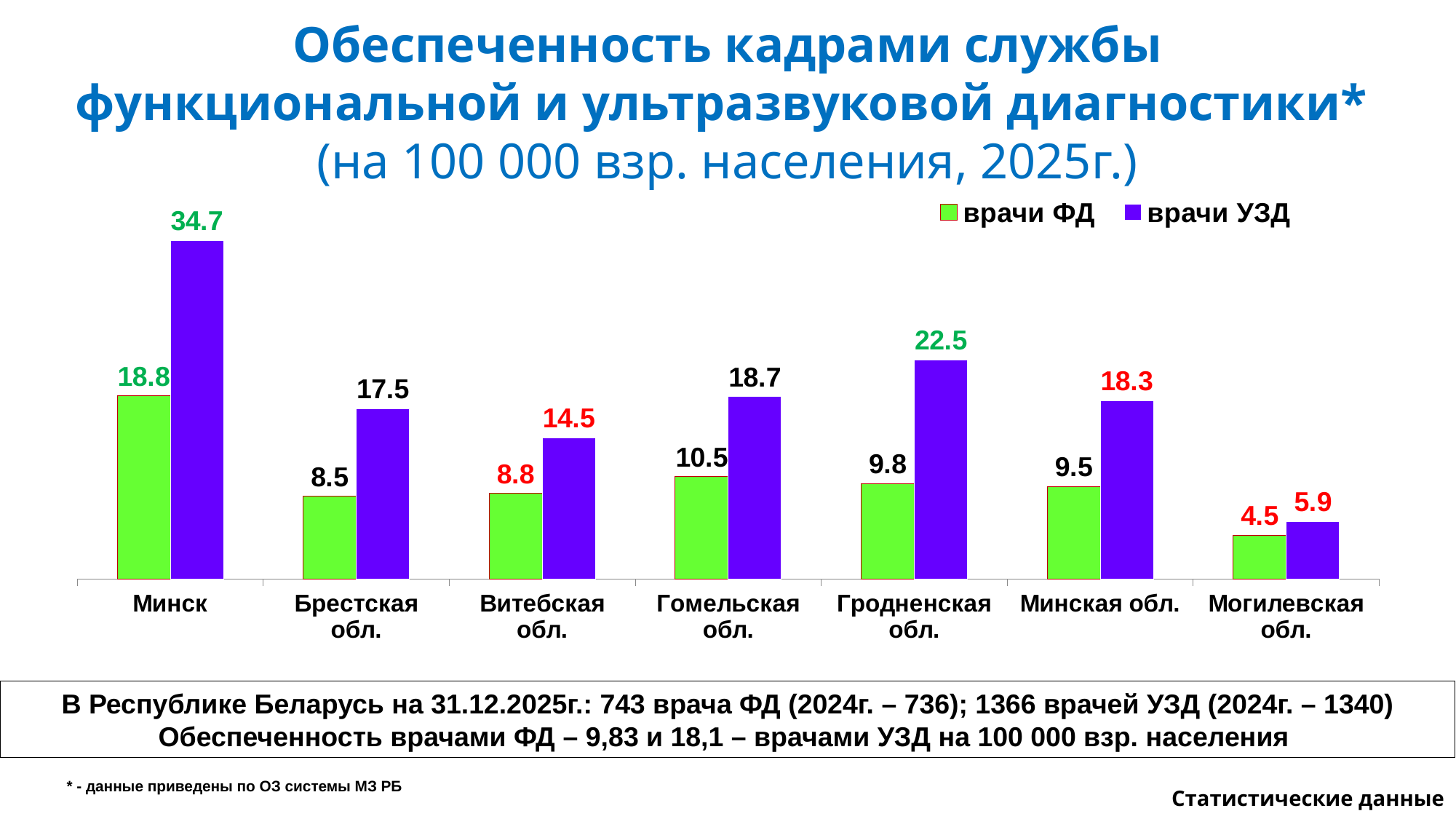
What kind of chart is shown on the slide? bar chart What is the value for врачи УЗД in Минск? 34.7 Which is larger: врачи ФД in Гомельская обл. or врачи ФД in Витебская обл.? Гомельская обл. Which region has the lowest value for врачи УЗД? Могилевская обл. What is the difference between the врачи УЗД values for Гродненская обл. and Брестская обл.? 5 What is the value for врачи ФД in Гродненская обл.? 9.8 Which region has the highest value for врачи ФД? Минск Which colour represents врачи УЗД in the chart? purple What is the value for врачи УЗД in Могилевская обл.? 5.9 What is the difference between врачи УЗД and врачи ФД in Минск? 15.9 How many regions are shown on the x axis? 7 How many series does the legend list? 2